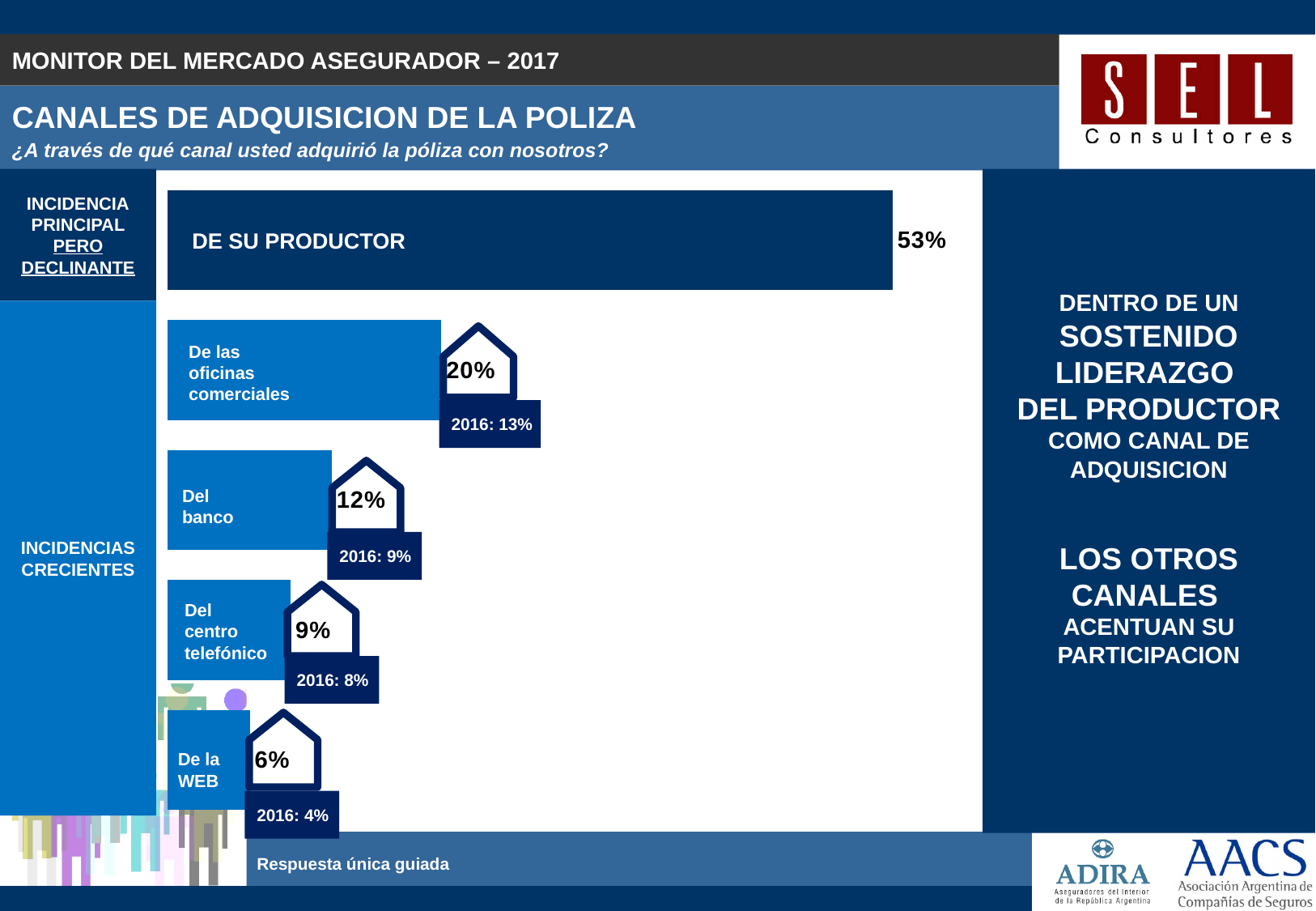
What percentage of respondents acquired the policy through their producer (De su productor)? 53% What was the 2016 value for 'Del centro telefónico'? 8% What was the 2016 value for 'Del banco'? 9% Which acquisition channel has the highest share? De su productor What is the 2017 value for 'De las oficinas comerciales'? 20% By how many percentage points did 'De las oficinas comerciales' grow from 2016 to 2017? 7 percentage points How many acquisition channels are shown in the chart? 5 What type of chart is used to show the acquisition channels? Bar chart What is the value shown for 'De la WEB' in 2017? 6% Which acquisition channel has the lowest share in 2017? De la WEB Which is larger: the 2017 value for 'Del centro telefónico' or for 'De la WEB'? Del centro telefónico What is the difference between the 2017 values for 'De su productor' and 'Del banco'? 41 percentage points